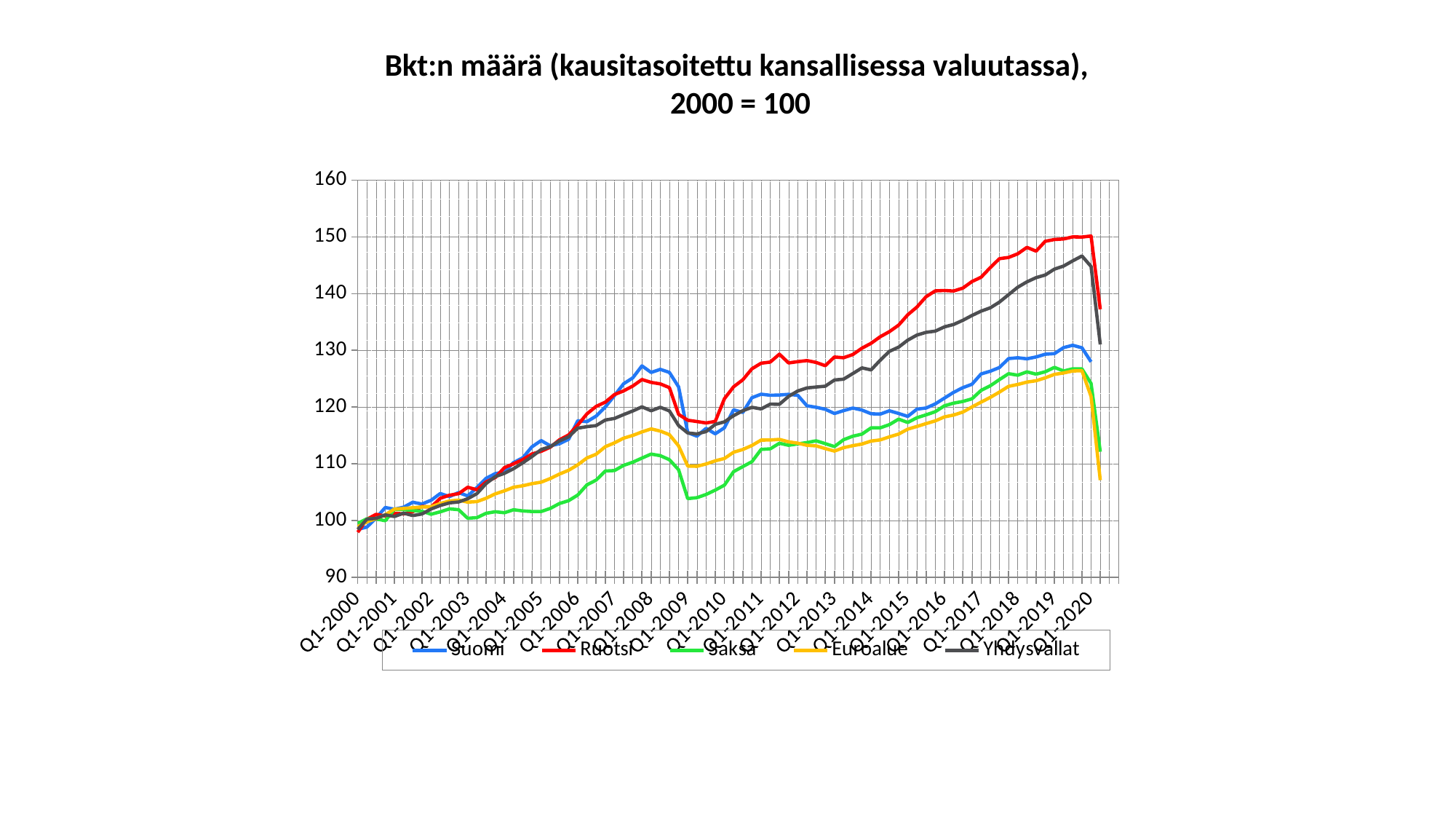
Is the value for Yhdysvallat at Q1-2020 greater or less than 140? greater At Q1-2020, which is larger: the value for Suomi or the value for Yhdysvallat? Yhdysvallat Is the value for Saksa at Q1-2010 greater or less than 110? less Which series has the highest value at Q1-2020? Ruotsi What is the title of the chart? Bkt:n määrä (kausitasoitettu kansallisessa valuutassa), 2000 = 100 How many series does the legend list? 5 What kind of chart is shown on the slide? line chart Does the Ruotsi series generally rise or fall between Q1-2010 and Q1-2020? rise Which series has the lowest value at Q1-2010? Saksa Which colour is used for the Ruotsi series? red Is the value for Ruotsi at Q1-2020 greater or less than 140? greater